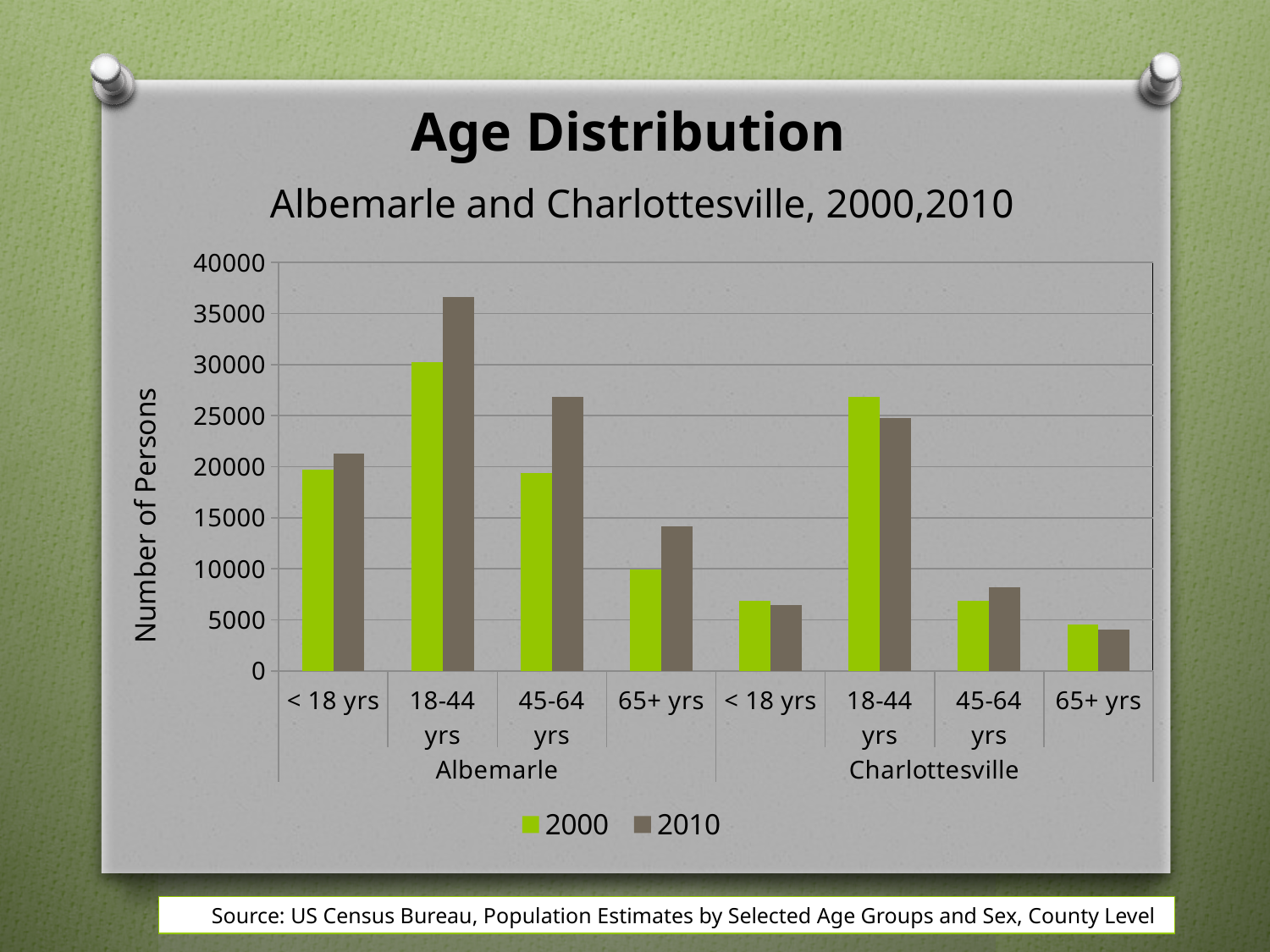
Which category has the lowest 2010 bar? Charlottesville 65+ yrs Is the 2010 value for Albemarle 65+ yrs greater or less than 15000? less How many age-group categories are plotted along the x axis in total? 8 For Albemarle 45-64 yrs, which year has the larger value, 2000 or 2010? 2010 Which series is shown in green in the legend? 2000 For Charlottesville 18-44 yrs, which year has the larger value, 2000 or 2010? 2000 Which category has the highest 2010 bar? Albemarle 18-44 yrs What is the label on the vertical axis? Number of Persons Is the 2010 value for Albemarle 18-44 yrs greater or less than 35000? greater What kind of chart is shown on the slide? bar chart How many series does the legend list? 2 Is the 2010 value for Charlottesville 45-64 yrs greater or less than 10000? less